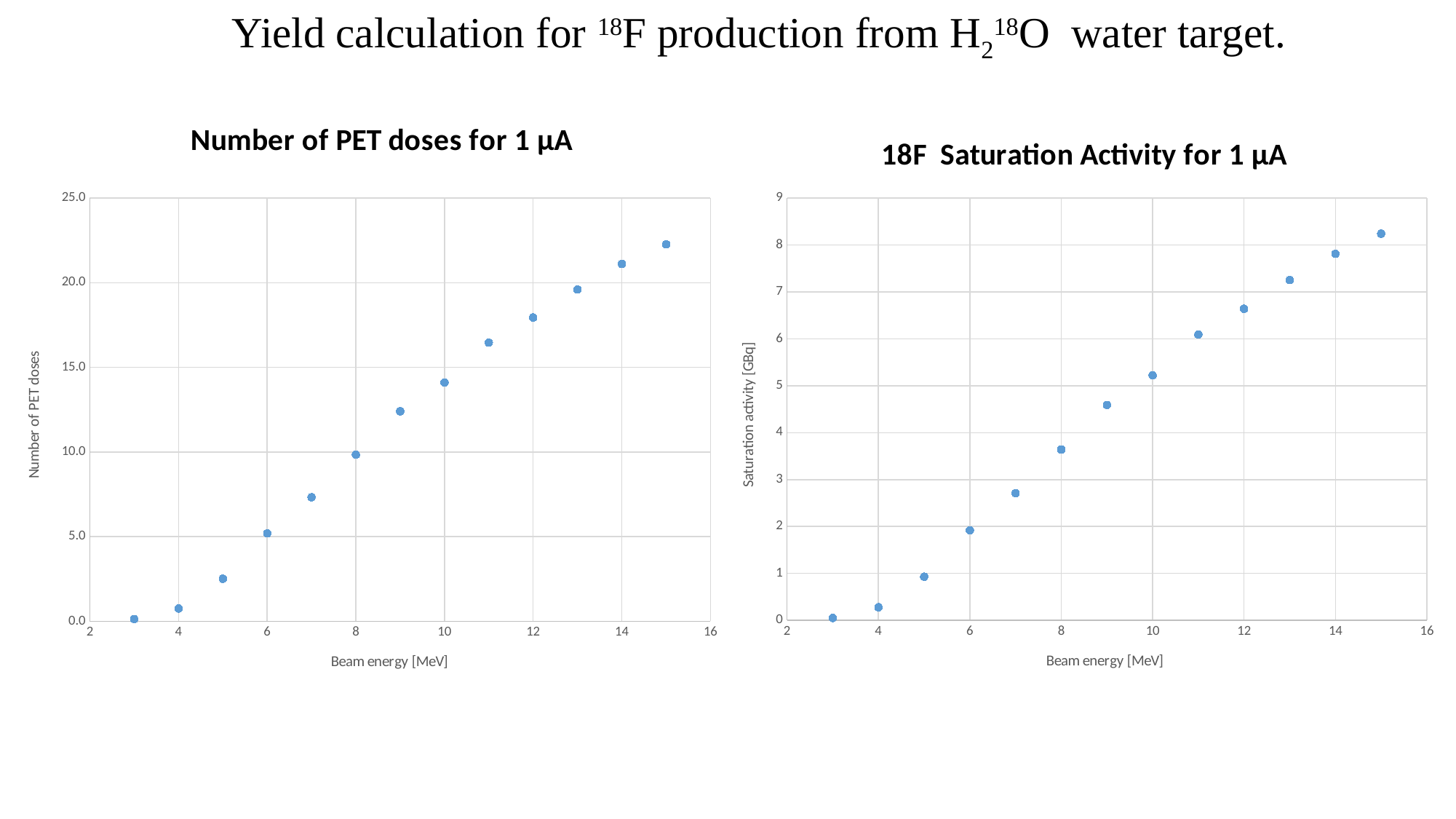
In the '18F Saturation Activity for 1 µA' chart, is the value at 8 MeV greater or less than 4 GBq? less In the '18F Saturation Activity for 1 µA' chart, at which beam energy is the saturation activity highest? 15 MeV In the '18F Saturation Activity for 1 µA' chart, is the value at 12 MeV greater or less than 7 GBq? less In the '18F Saturation Activity for 1 µA' chart, is the value at 9 MeV greater or less than 4 GBq? greater In the 'Number of PET doses for 1 µA' chart, which beam energy has the larger number of PET doses, 8 MeV or 12 MeV? 12 MeV What kind of chart is the 'Number of PET doses for 1 µA' chart? scatter chart In the 'Number of PET doses for 1 µA' chart, do the values rise or fall as beam energy increases? rise What is the x-axis label of the '18F Saturation Activity for 1 µA' chart? Beam energy [MeV] How many data points are plotted in the '18F Saturation Activity for 1 µA' chart? 13 In the 'Number of PET doses for 1 µA' chart, at which beam energy is the number of PET doses lowest? 3 MeV